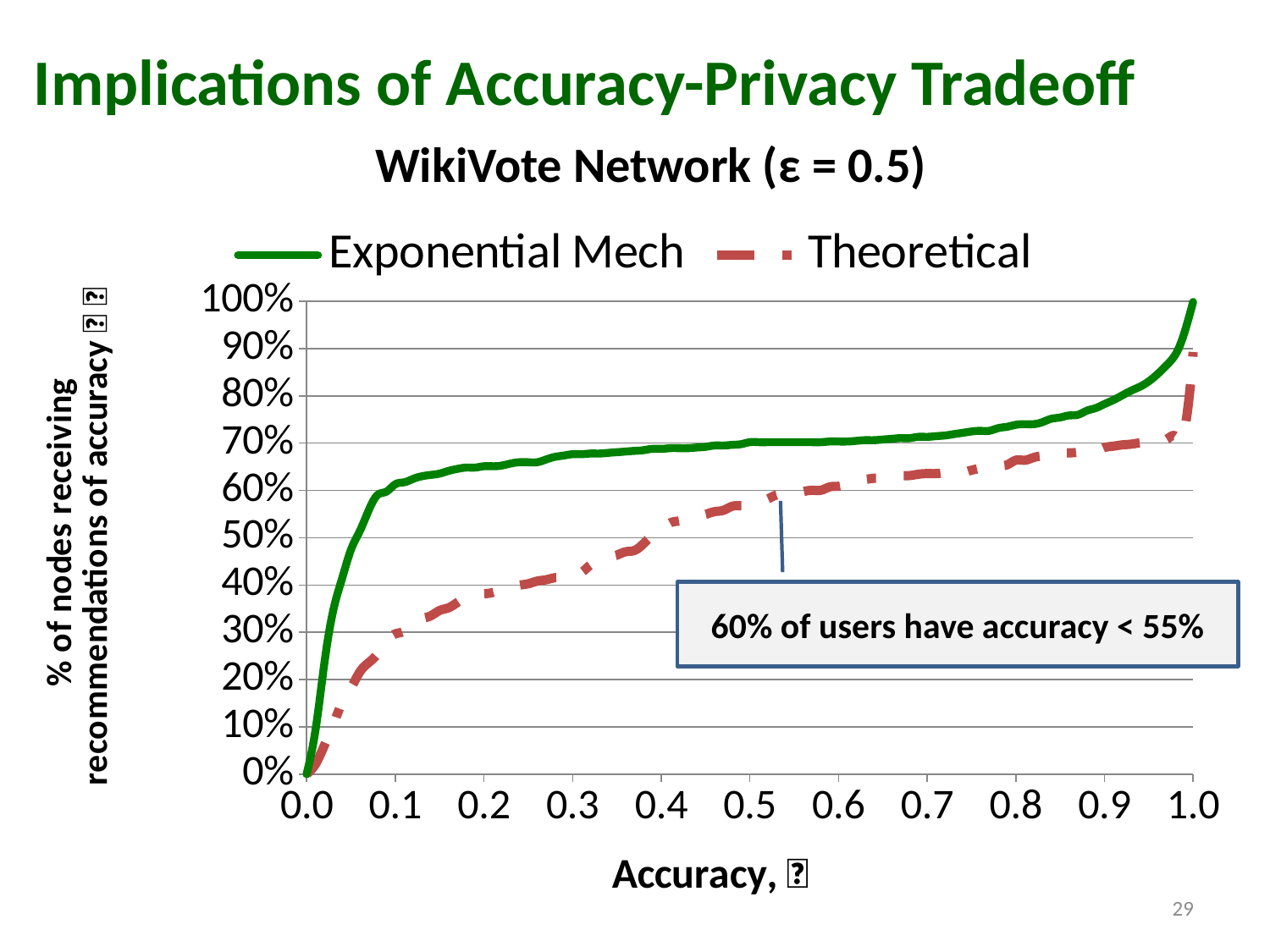
Is the value of the Exponential Mech series at accuracy 0.9 greater or less than 70%? greater Which series is drawn with a dashed line? Theoretical Is the value of the Theoretical series at accuracy 0.1 greater or less than 40%? less At accuracy 0.5, which series has the higher value, Exponential Mech or Theoretical? Exponential Mech Is the value of the Theoretical series at accuracy 0.8 greater or less than 70%? less Do the values of the Theoretical series rise or fall as accuracy increases from 0.0 to 1.0? rise What kind of chart is shown on the slide? line chart How many tick labels are shown on the x axis? 11 How many series does the legend list? 2 What is the title of the chart? WikiVote Network (ε = 0.5)